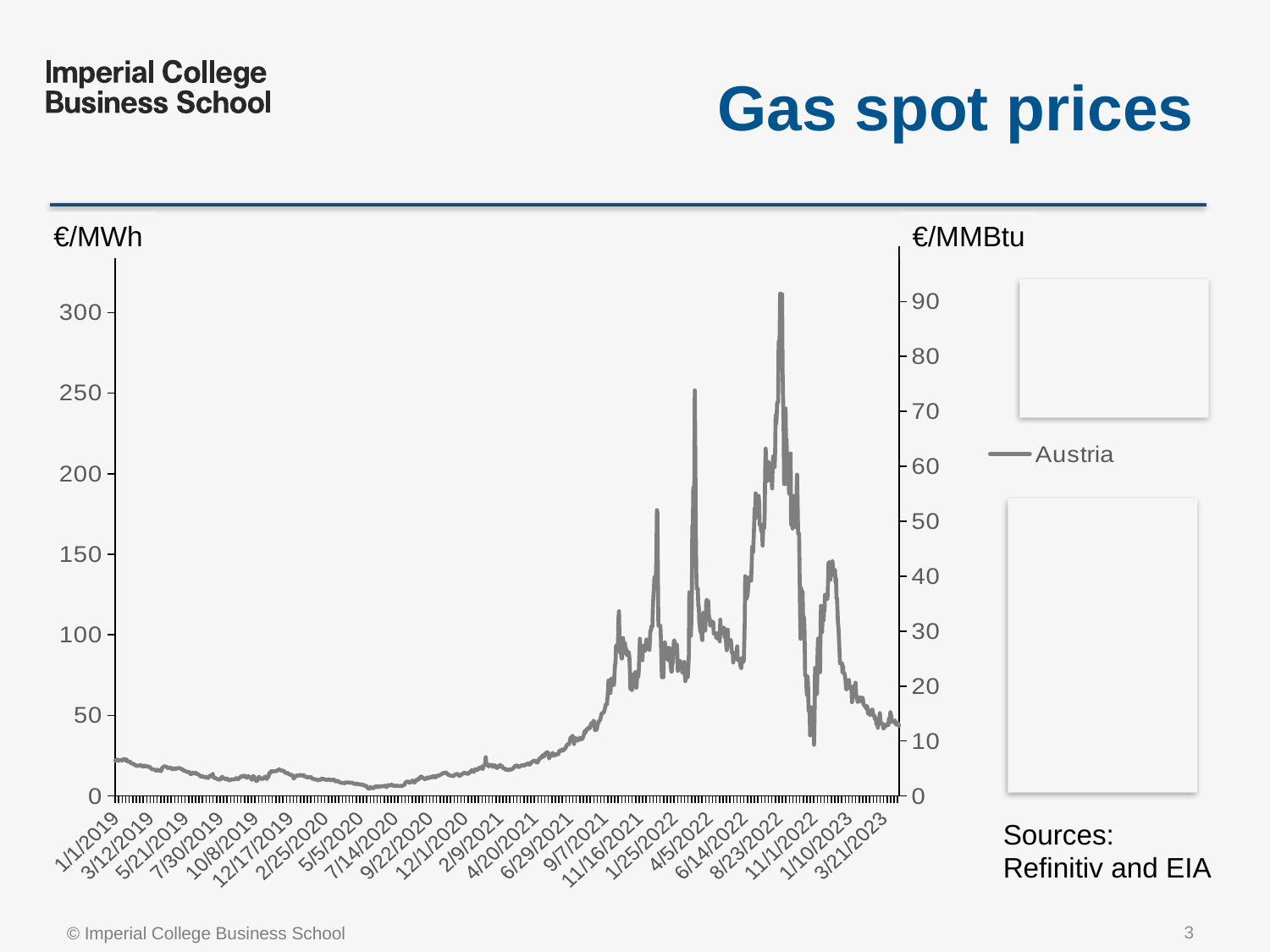
How many series does the legend list? 1 What is the name of the series shown in the legend? Austria Around which x-axis date does the Austria series reach its highest value? 8/23/2022 Is the value for Austria on 1/1/2019 greater or less than 50 €/MWh? less How many date labels are shown on the x axis? 23 Do the values for Austria rise or fall between 7/14/2020 and 8/23/2022? rise Is the value for Austria on 3/21/2023 greater or less than 100 €/MWh? less What kind of chart is shown on the slide? line chart Is the value for Austria on 1/25/2022 greater or less than 50 €/MWh? greater What is the title of the slide's chart? Gas spot prices Do the values for Austria rise or fall between 8/23/2022 and 3/21/2023? fall